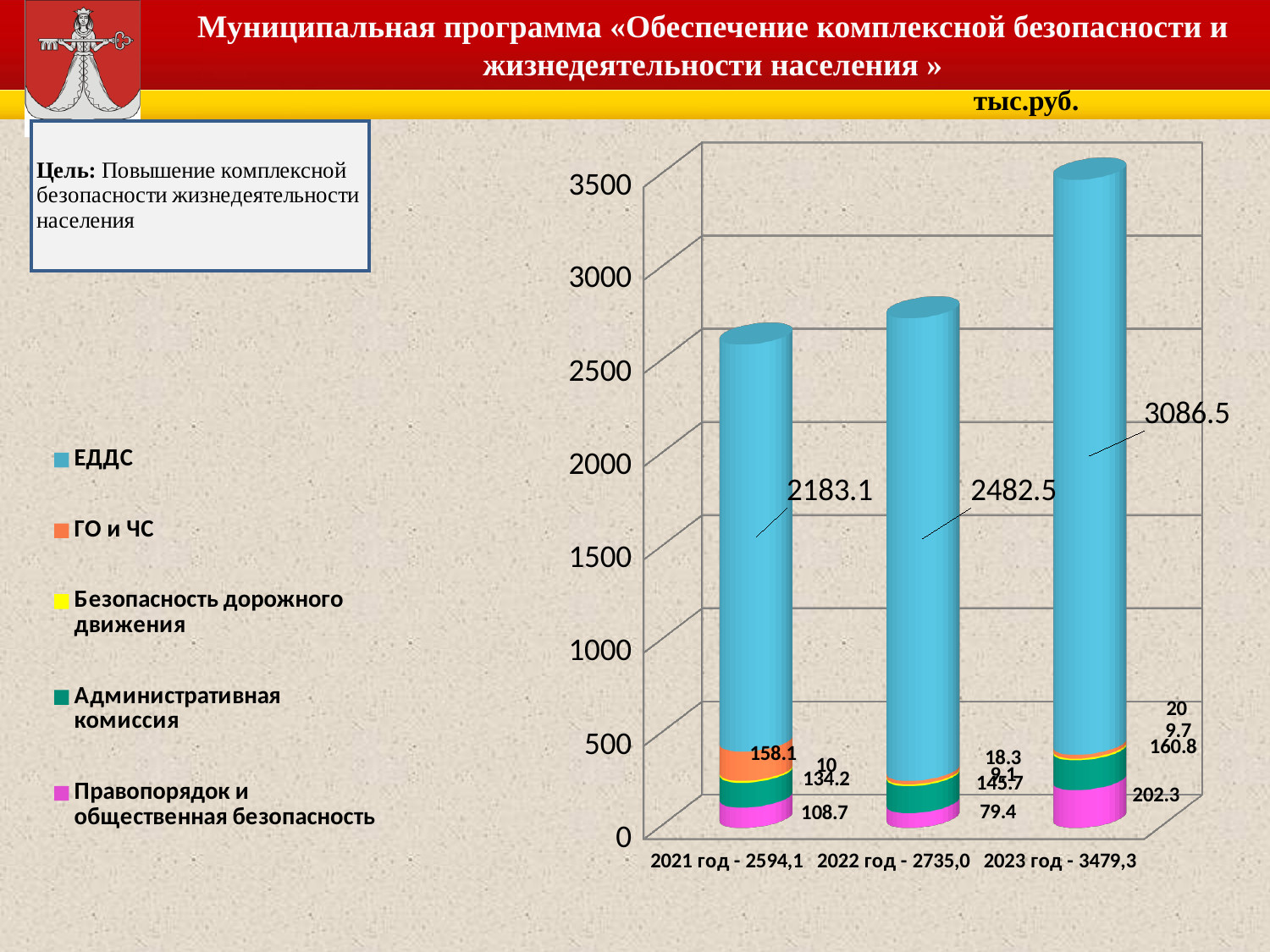
Does the ЕДДС value rise or fall from 2021 год to 2023 год? Rises What is the value of ЕДДС for 2023 год? 3086.5 What is the value of Правопорядок и общественная безопасность for 2022 год? 79.4 How many series does the legend list? 5 How many years (categories) are shown on the x axis? 3 What kind of chart is shown on the slide? Stacked bar chart Which is larger: the ГО и ЧС value for 2021 год or for 2022 год? 2021 год In which year is the Правопорядок и общественная безопасность value the lowest? 2022 год What is the total of the stacked bar for 2023 год? 3479,3 What is the value of ГО и ЧС for 2021 год? 158.1 What is the difference between the ЕДДС values for 2023 год and 2022 год? 604 In which year is the ЕДДС value the highest? 2023 год